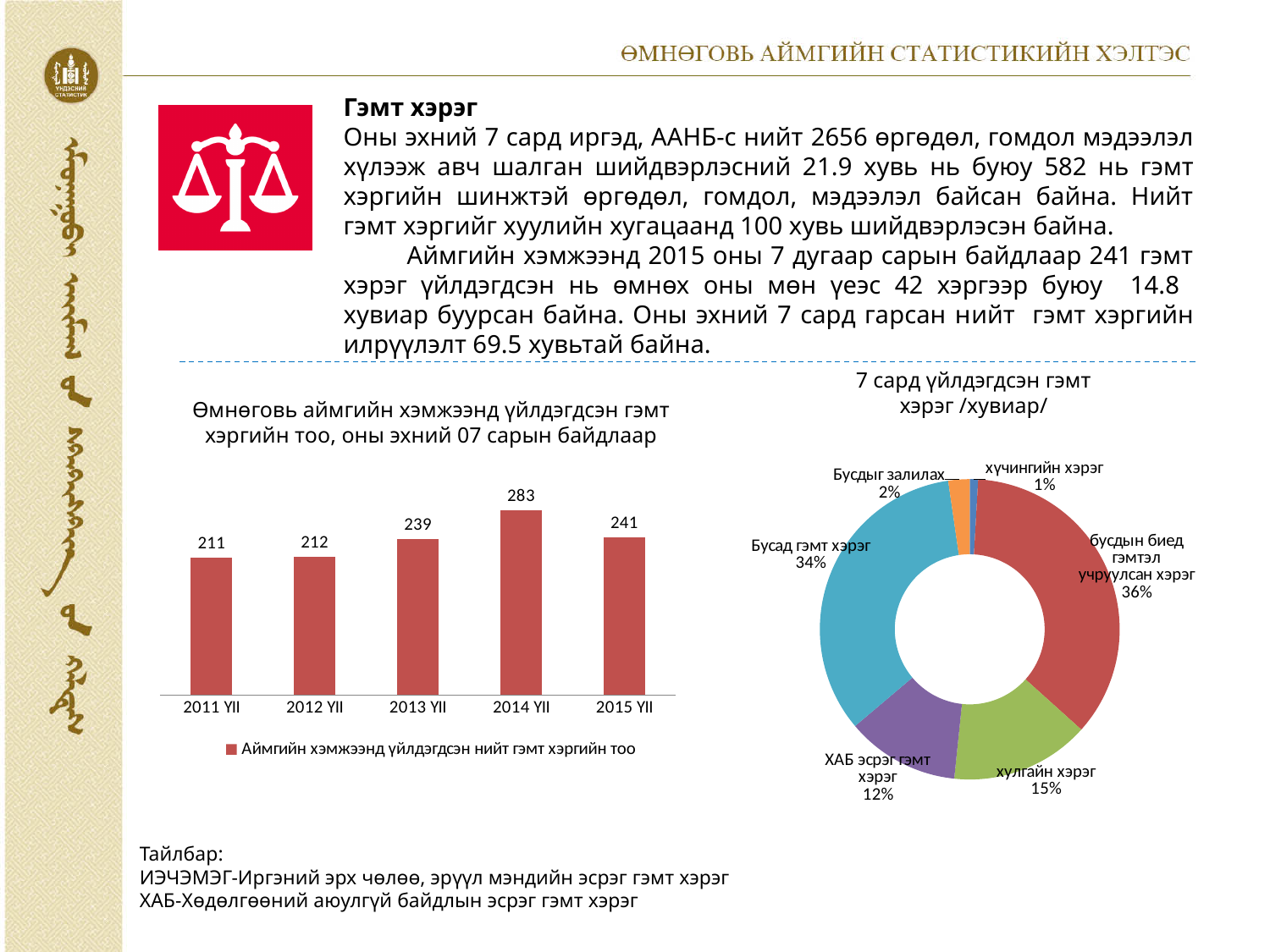
How many bars are shown in the bar chart on the left? 5 How many categories are shown in the doughnut chart on the right? 6 What type of chart is the chart on the left of the slide? Bar chart In the bar chart on the left, which is larger: the value for 2013 YII or the value for 2015 YII? 2015 YII In the bar chart on the left, which year has the highest value? 2014 YII In the bar chart on the left, what is the difference between the values for 2014 YII and 2015 YII? 42 In the doughnut chart on the right, what share does 'Бусад гэмт хэрэг' have? 34% In the bar chart on the left, what is the value for 2014 YII? 283 In the bar chart on the left, which year has the lowest value? 2011 YII In the doughnut chart on the right, which category has the largest share? бусдын биед гэмтэл учруулсан хэрэг In the doughnut chart on the right, what share does 'хулгайн хэрэг' have? 15% In the bar chart on the left, what is the value for 2011 YII? 211